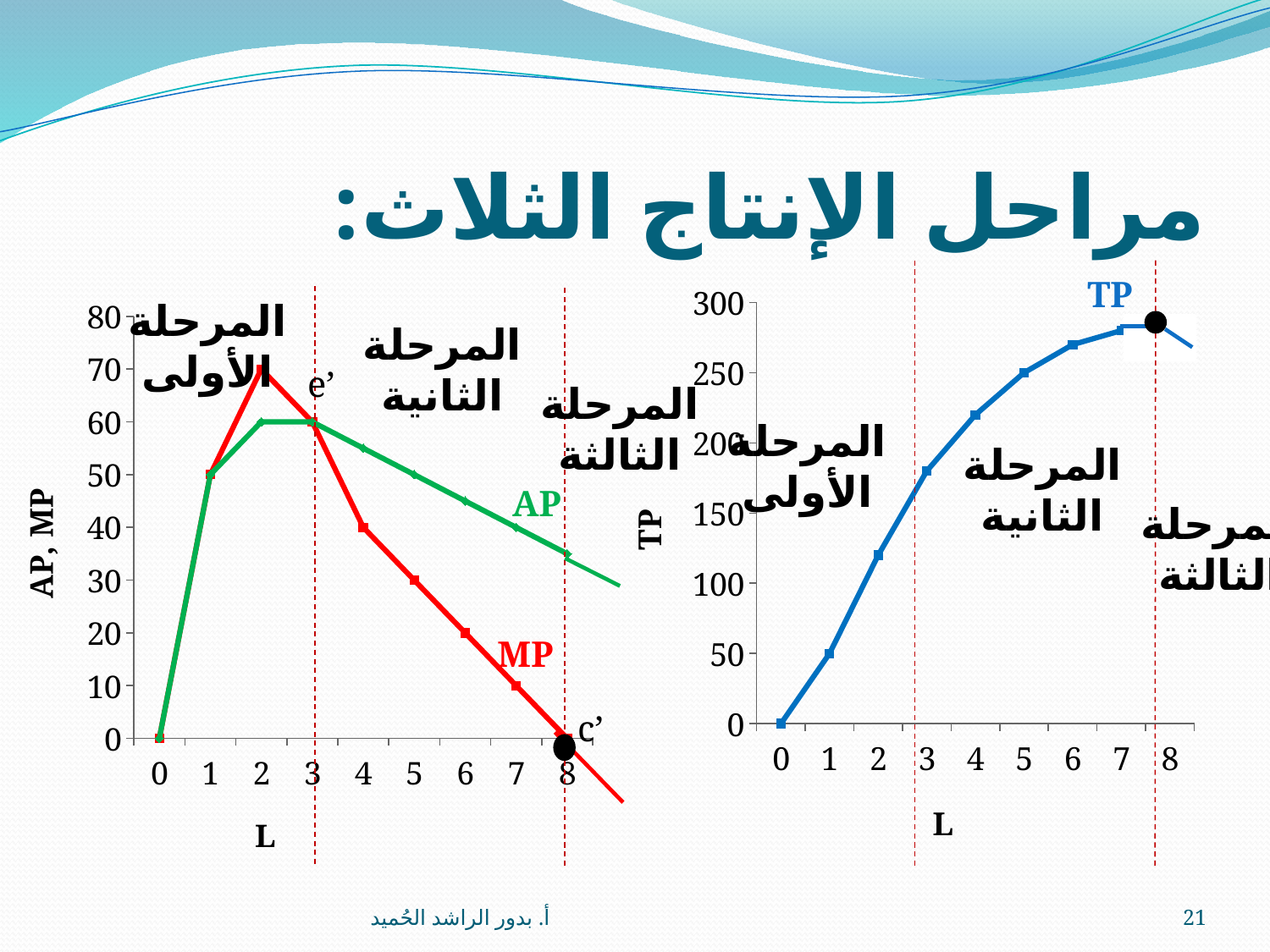
On the right chart (TP against L), is the value of TP at L = 3 greater or less than 150? greater On the left chart (AP, MP against L), what label marks the point where MP reaches zero at L = 8? c' On the left chart (AP, MP against L), at which value of L does MP reach its highest point? 2 On the left chart (AP, MP against L), what is the value of AP at L = 3? 60 On the left chart (AP, MP against L), what is the difference between MP at L = 2 and MP at L = 3? 10 How many series are plotted on the left chart (AP, MP against L)? 2 On the right chart (TP against L), does TP rise or fall as L increases from 0 to 7? rises On the left chart (AP, MP against L), what is the value of MP at L = 8? 0 On the right chart (TP against L), what is the value of TP at L = 5? 250 On the left chart (AP, MP against L), at L = 5, which is larger, AP or MP? AP What kind of chart is the left chart (AP, MP against L)? line chart On the left chart (AP, MP against L), what is the value of MP at L = 2? 70